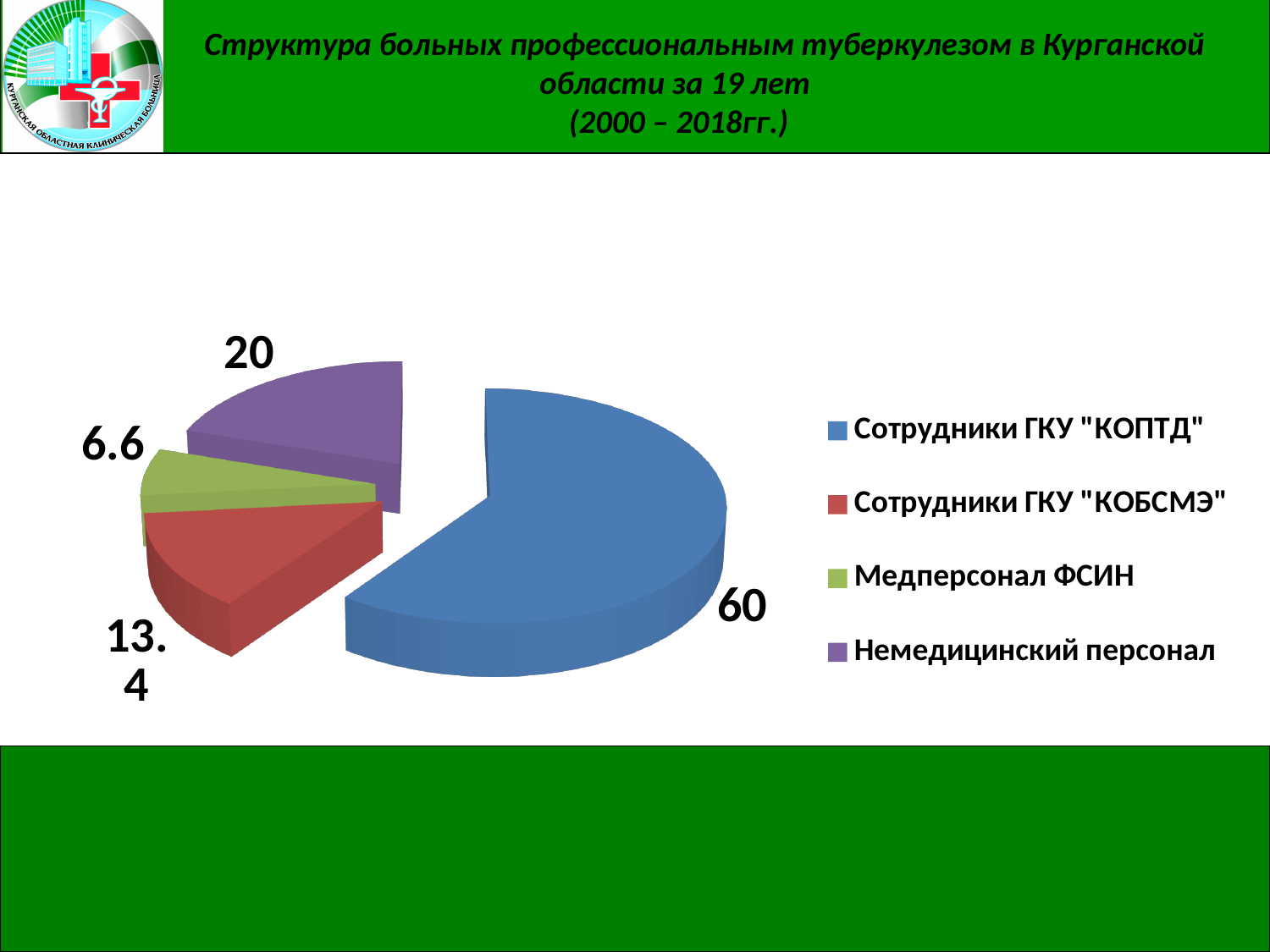
How many entries does the legend list? 4 What colour is the slice for Немедицинский персонал? purple What kind of chart is shown on the slide? pie chart What is the value for Медперсонал ФСИН? 6.6 Which is larger, the value for Немедицинский персонал or the value for Сотрудники ГКУ "КОБСМЭ"? Немедицинский персонал What is the value for Сотрудники ГКУ "КОБСМЭ"? 13.4 What is the value for Немедицинский персонал? 20 What is the value for Сотрудники ГКУ "КОПТД"? 60 Which category has the smallest slice of the pie? Медперсонал ФСИН Which category has the largest slice of the pie? Сотрудники ГКУ "КОПТД" How many slices does the pie chart have? 4 What is the difference between the values for Немедицинский персонал and Сотрудники ГКУ "КОБСМЭ"? 6.6